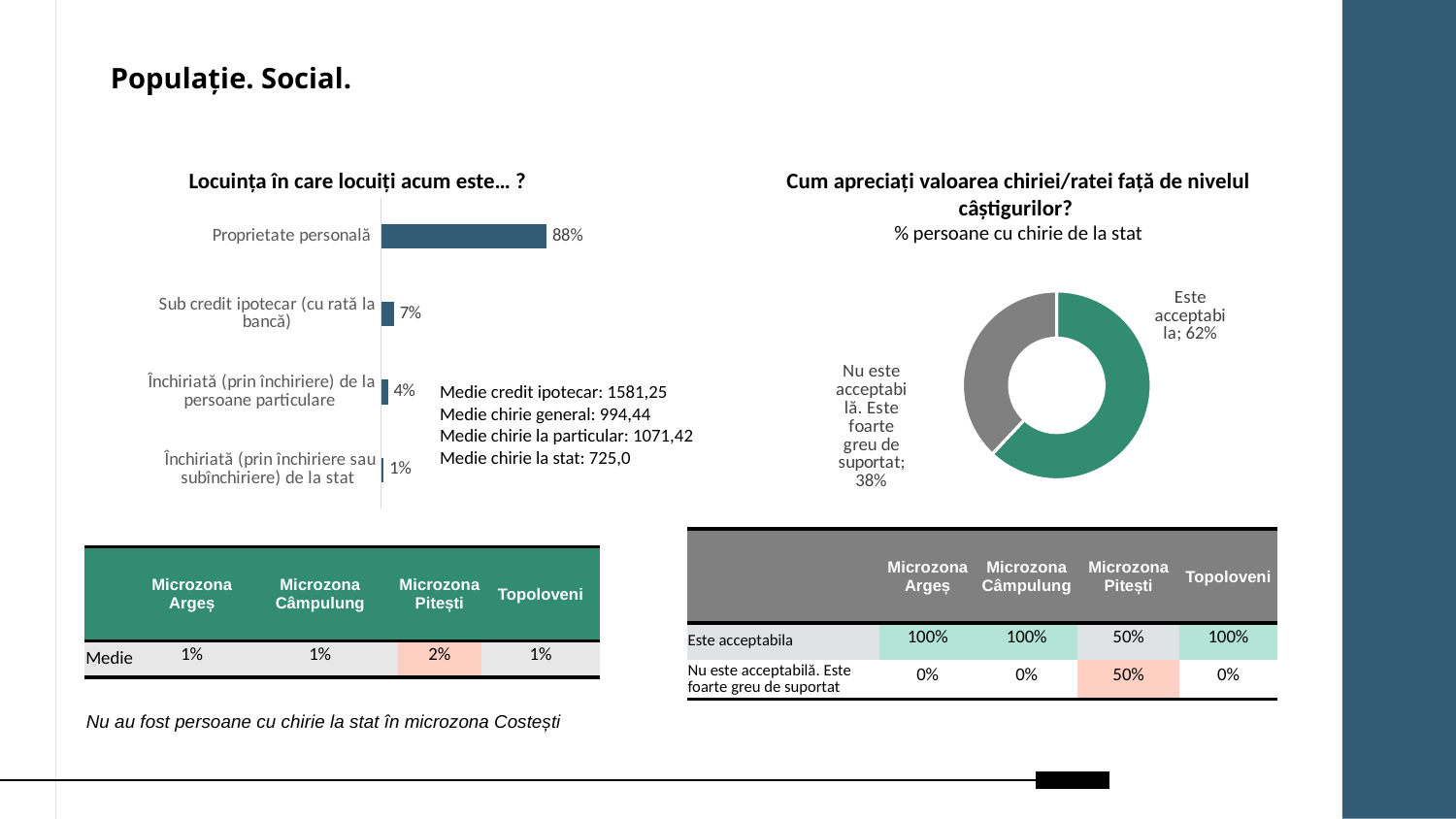
In the bar chart 'Locuința în care locuiți acum este… ?', which category has the lowest value? Închiriată (prin închiriere sau subînchiriere) de la stat In the bar chart 'Locuința în care locuiți acum este… ?', what is the difference between 'Proprietate personală' and 'Sub credit ipotecar (cu rată la bancă)'? 81% In the bar chart 'Locuința în care locuiți acum este… ?', what is the value for 'Închiriată (prin închiriere) de la persoane particulare'? 4% In the bar chart 'Locuința în care locuiți acum este… ?', how many categories are shown? 4 In the chart 'Cum apreciați valoarea chiriei/ratei față de nivelul câștigurilor?', which slice is larger: 'Este acceptabila' or 'Nu este acceptabilă. Este foarte greu de suportat'? Este acceptabila In the bar chart 'Locuința în care locuiți acum este… ?', what is the value for 'Sub credit ipotecar (cu rată la bancă)'? 7% In the chart 'Cum apreciați valoarea chiriei/ratei față de nivelul câștigurilor?', what share is 'Nu este acceptabilă. Este foarte greu de suportat'? 38% What type of chart is 'Cum apreciați valoarea chiriei/ratei față de nivelul câștigurilor?'? Doughnut (pie) chart What type of chart is 'Locuința în care locuiți acum este… ?'? Bar chart In the chart 'Cum apreciați valoarea chiriei/ratei față de nivelul câștigurilor?', what share is 'Este acceptabila'? 62% In the bar chart 'Locuința în care locuiți acum este… ?', which category has the highest value? Proprietate personală In the bar chart 'Locuința în care locuiți acum este… ?', what is the value for 'Proprietate personală'? 88%